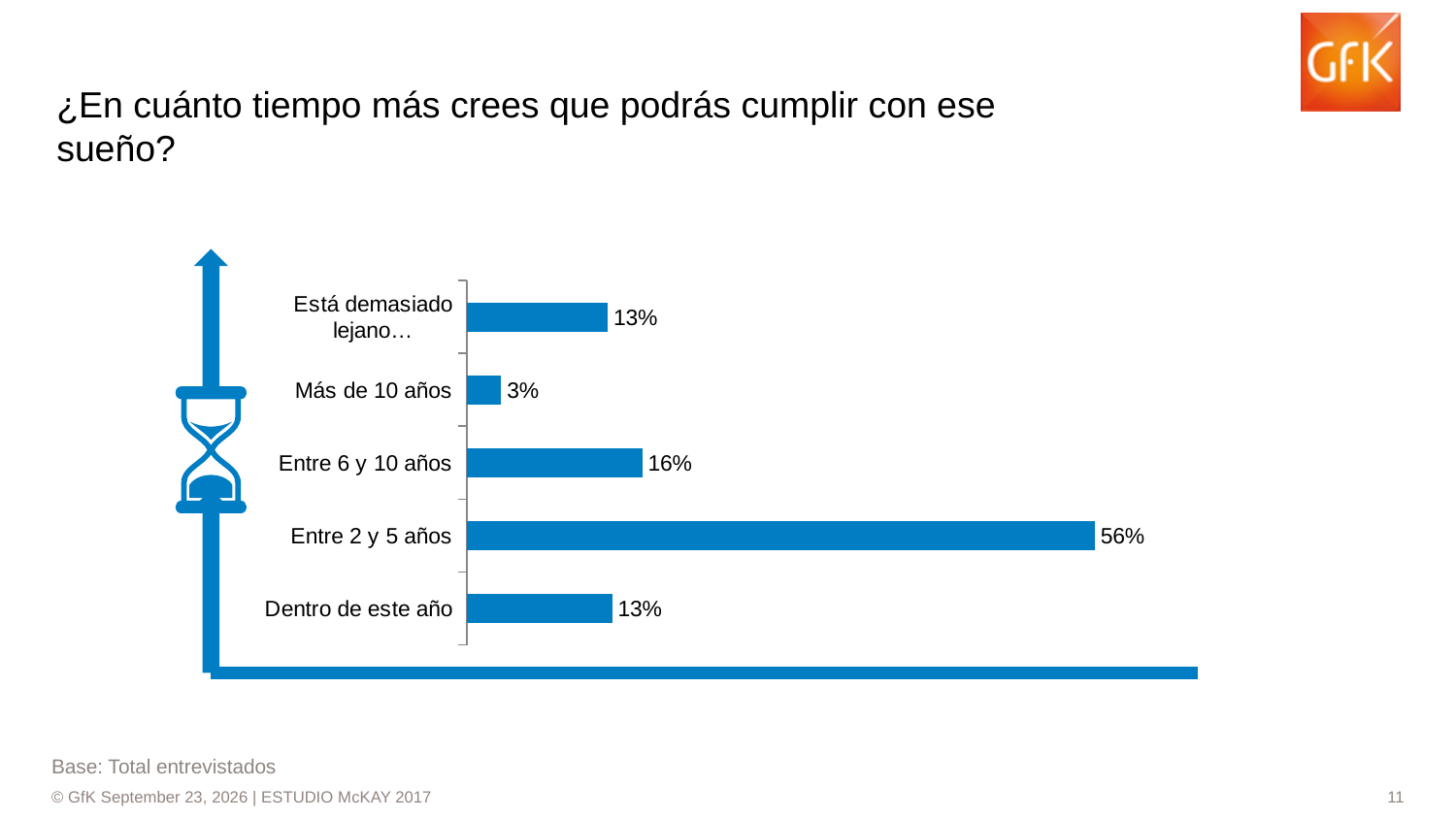
What is the value for "Entre 6 y 10 años"? 16% Which category has the highest value? Entre 2 y 5 años What colour are the bars in the chart? Blue What kind of chart is shown on the slide? Bar chart What is the difference between the values for "Entre 2 y 5 años" and "Entre 6 y 10 años"? 40% Which category has the lowest value? Más de 10 años What is the difference between the values for "Entre 6 y 10 años" and "Más de 10 años"? 13% Which is larger, the value for "Entre 6 y 10 años" or the value for "Dentro de este año"? Entre 6 y 10 años What is the value for "Más de 10 años"? 3% What is the value for "Entre 2 y 5 años"? 56% What is the value for "Dentro de este año"? 13% How many categories are shown in the chart? 5